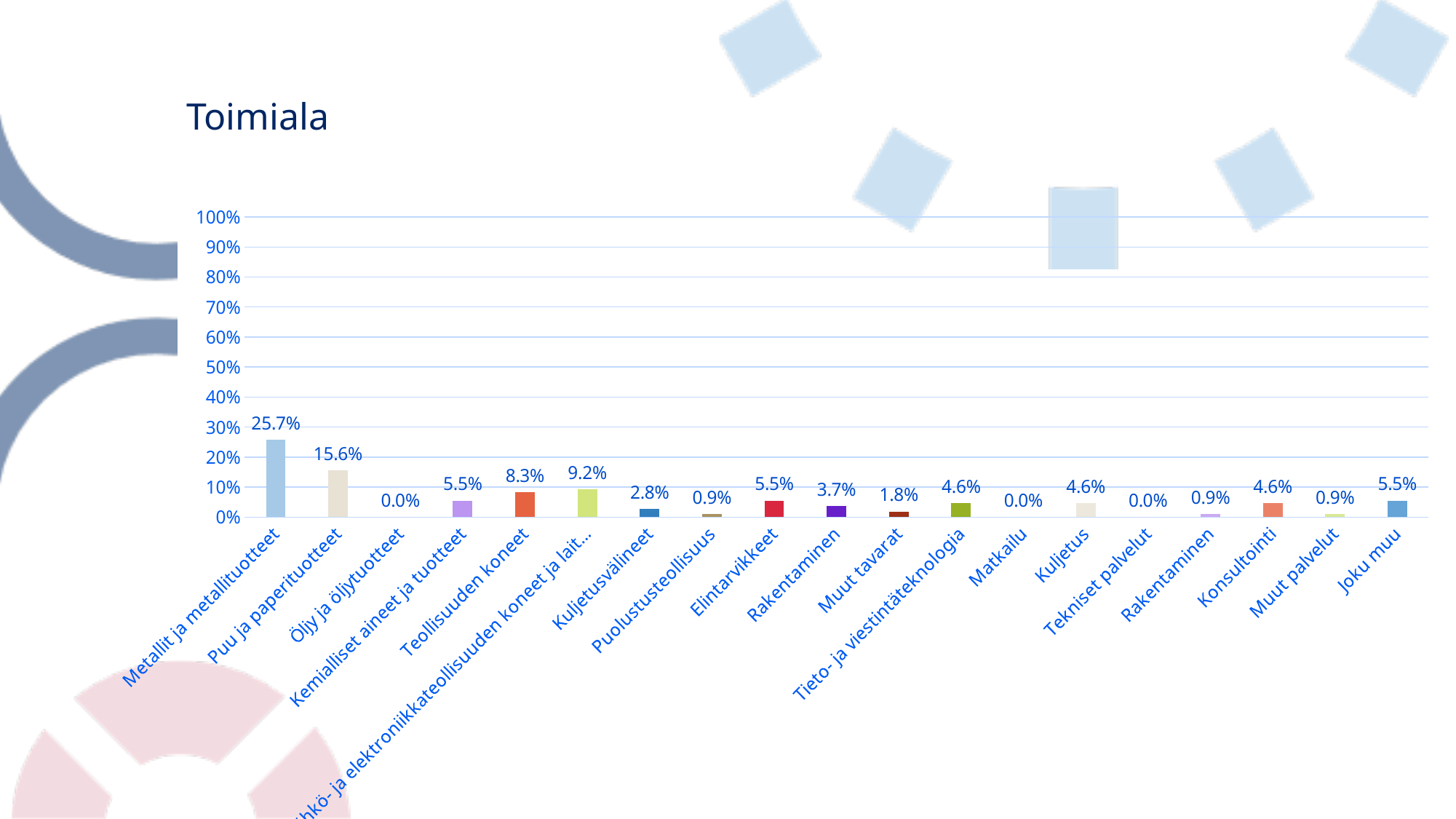
What is the value for Metallit ja metallituotteet? 25.7% What is the title of the slide? Toimiala What is the difference between the values for Metallit ja metallituotteet and Puu ja paperituotteet? 10.1% What is the value for Puu ja paperituotteet? 15.6% How many categories are shown on the x axis? 19 What type of chart is shown on the slide? bar chart Which category has the highest value? Metallit ja metallituotteet What is the value for Teollisuuden koneet? 8.3% What is the value for Kuljetusvälineet? 2.8% Which is larger, the value for Teollisuuden koneet or the value for Elintarvikkeet? Teollisuuden koneet What is the value for Matkailu? 0.0% What is the value for Joku muu? 5.5%